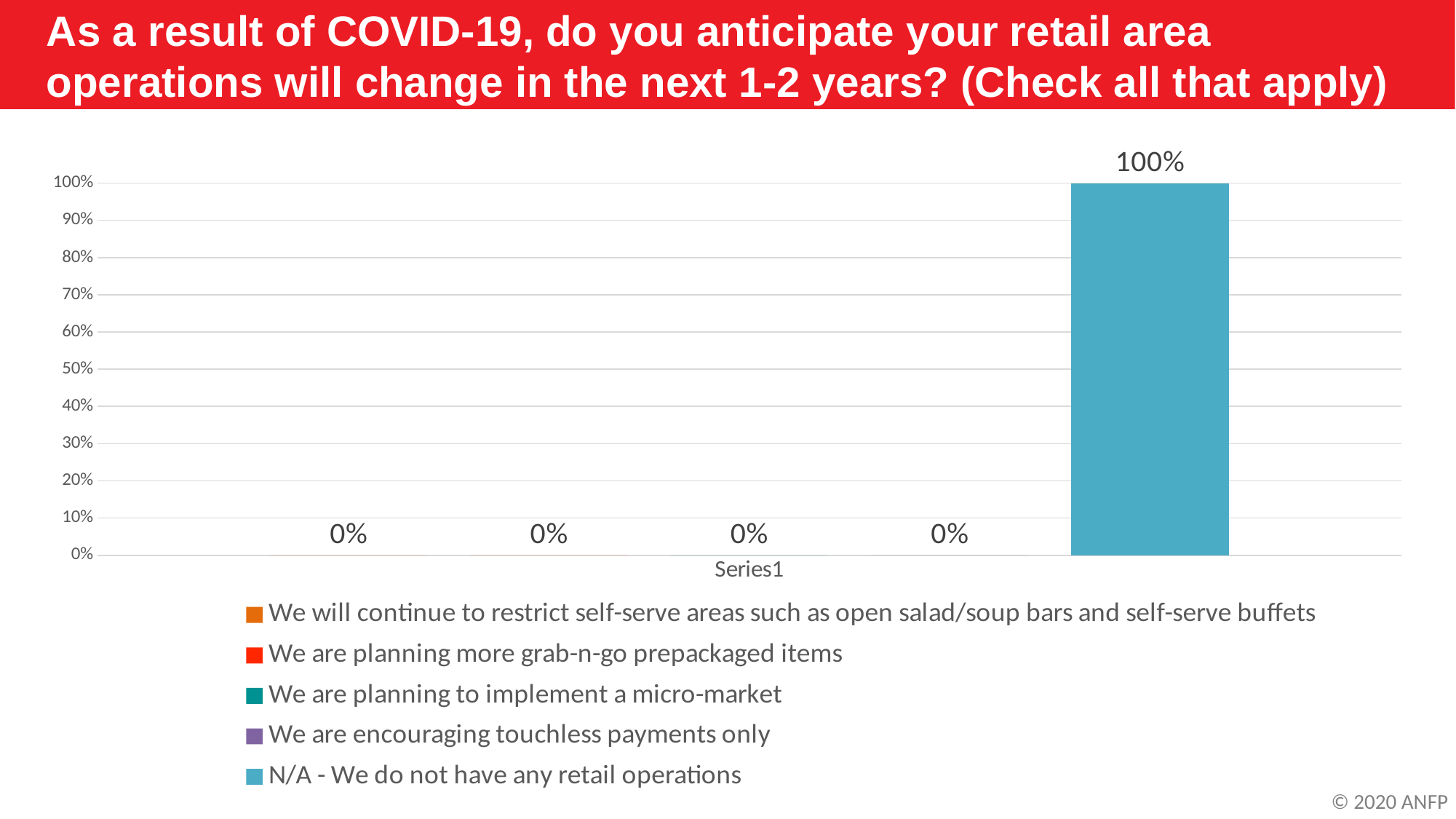
What is the value for "We are planning more grab-n-go prepackaged items"? 0% What is the value for "We are planning to implement a micro-market"? 0% What is the label shown on the x axis beneath the bars? Series1 What kind of chart is shown on the slide? bar chart Which legend entry has the highest value? N/A - We do not have any retail operations What is the value for "We are encouraging touchless payments only"? 0% What is the difference between the value for "N/A - We do not have any retail operations" and the value for "We are planning more grab-n-go prepackaged items"? 100% What is the value for "N/A - We do not have any retail operations"? 100% How many series does the legend list? 5 Which is larger: the value for "N/A - We do not have any retail operations" or the value for "We are encouraging touchless payments only"? N/A - We do not have any retail operations Is the value for "N/A - We do not have any retail operations" greater or less than 50%? greater How many of the legend entries have a value of 0%? 4